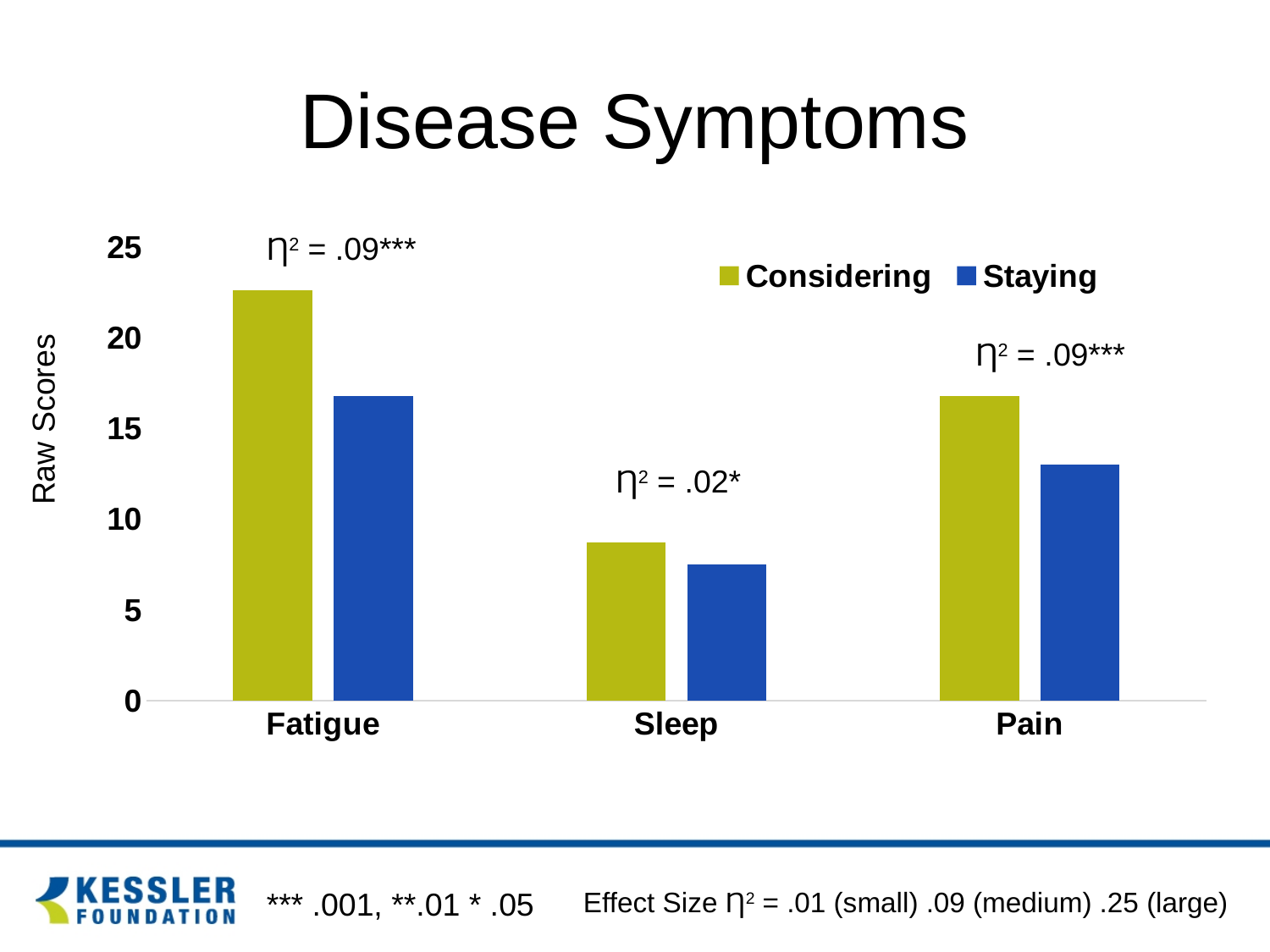
What effect size annotation is printed above the Sleep bars? η² = .02* Which symptom has the highest Considering score? Fatigue For Fatigue, which group has the larger raw score, Considering or Staying? Considering What is the label on the y axis? Raw Scores Is the Staying value for Sleep greater or less than 10? less How many symptom categories are shown on the x axis? 3 Is the Staying value for Pain greater or less than 15? less What kind of chart is shown on the slide? bar chart Which symptom has the lowest Staying score? Sleep Is the Considering value for Fatigue greater or less than 20? greater How many series does the legend list? 2